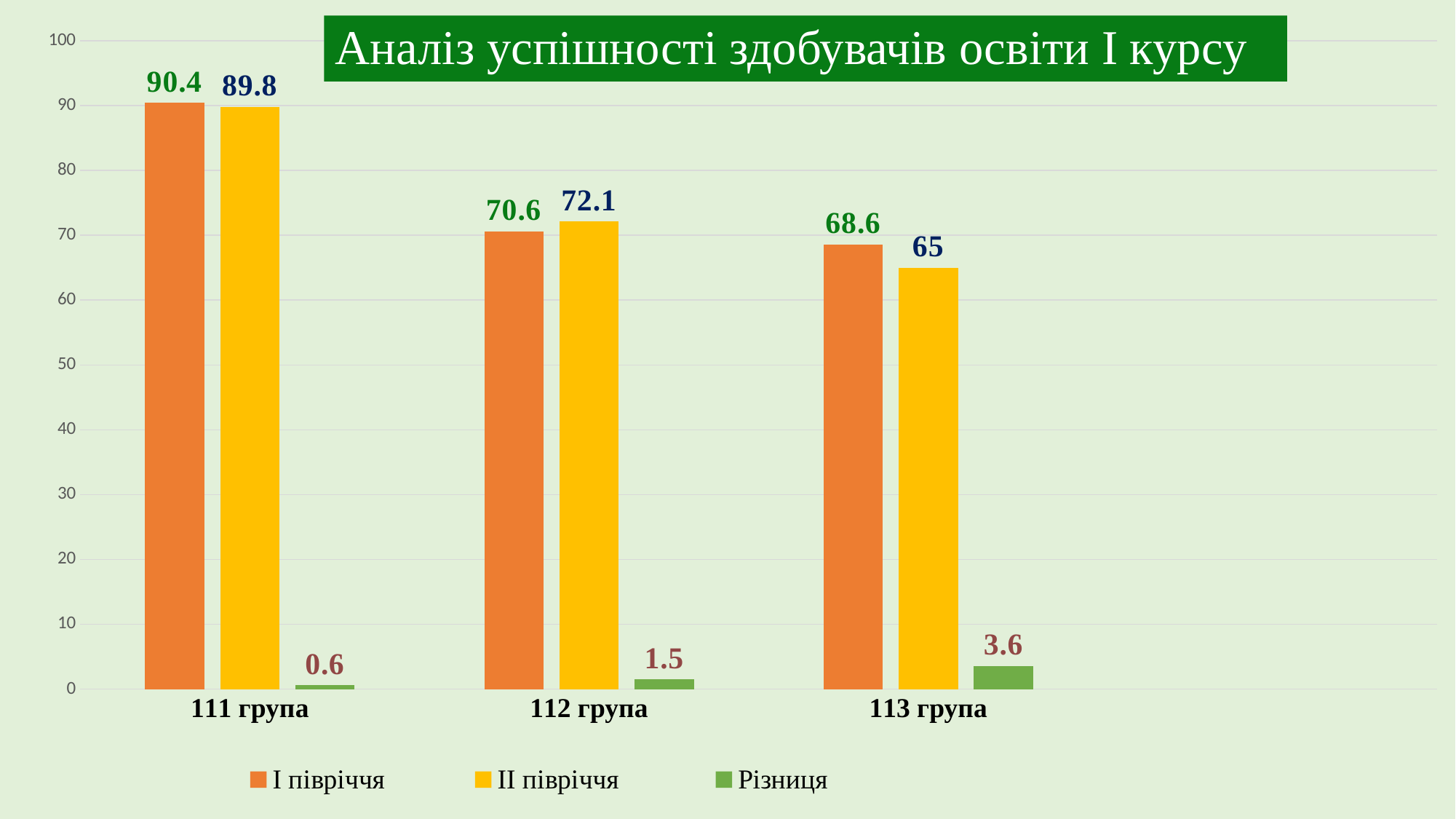
Is the value for I півріччя for 112 група greater or less than 80? less How many groups are shown on the x axis? 3 What kind of chart is shown on the slide? bar chart What is the value for II півріччя for 113 група? 65 What is the value for II півріччя for 112 група? 72.1 How many series does the legend list? 3 Which group has the lowest value for II півріччя? 113 група Which group has the highest value for I півріччя? 111 група What is the value for Різниця for 113 група? 3.6 What is the value for I півріччя for 111 група? 90.4 What is the difference between the I півріччя and II півріччя values for 113 група? 3.6 Which is larger for 112 група: I півріччя or II півріччя? II півріччя